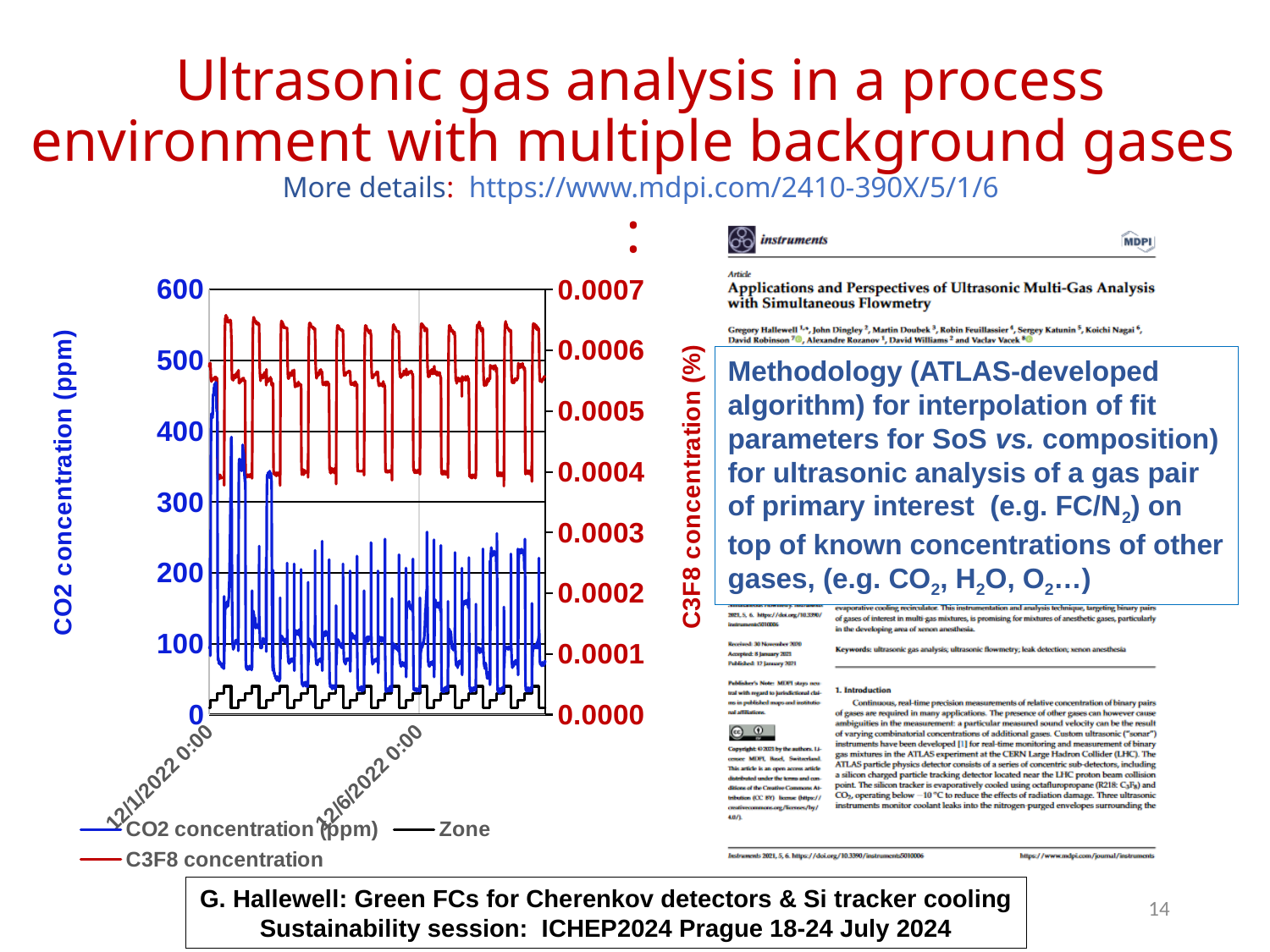
Which series in the chart is drawn in blue? CO2 concentration (ppm) What is the first date label shown on the x axis of the chart? 12/1/2022 0:00 What is the maximum value shown on the left vertical axis (CO2 concentration) of the chart? 600 What is the title of the left vertical axis of the chart? CO2 concentration (ppm) How many series does the legend of the chart list? 3 What is the maximum value shown on the right vertical axis (C3F8 concentration) of the chart? 0.0007 Are the upper plateaus of the C3F8 concentration series greater or less than 0.0005 on the right axis? greater Are the lower plateaus of the C3F8 concentration series greater or less than 0.0005 on the right axis? less Is the highest CO2 concentration value reached in the chart greater or less than 400 ppm? greater Which series in the chart is drawn in red? C3F8 concentration What kind of chart is shown on the left of the slide? line chart